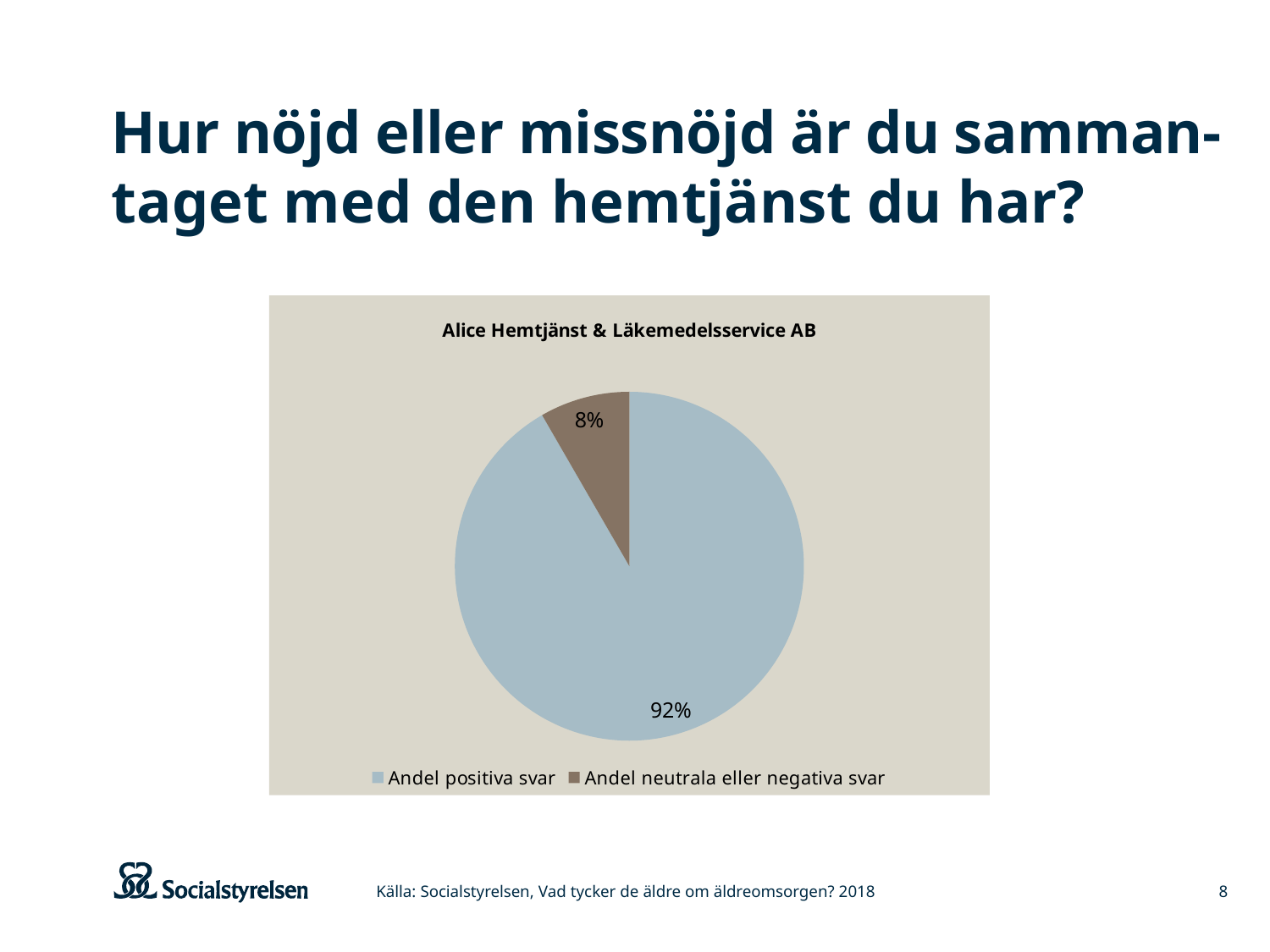
What is the difference in percentage points between 'Andel positiva svar' and 'Andel neutrala eller negativa svar'? 84 Which slice is the largest? Andel positiva svar What is the chart's title? Alice Hemtjänst & Läkemedelsservice AB Which is larger, 'Andel positiva svar' or 'Andel neutrala eller negativa svar'? Andel positiva svar How many slices does the pie chart have? 2 Which slice is the smallest? Andel neutrala eller negativa svar What kind of chart is shown on the slide? pie chart What share of the pie is 'Andel neutrala eller negativa svar'? 8% What colour is the 'Andel neutrala eller negativa svar' slice? brown How many entries does the legend list? 2 What share of the pie is 'Andel positiva svar'? 92%